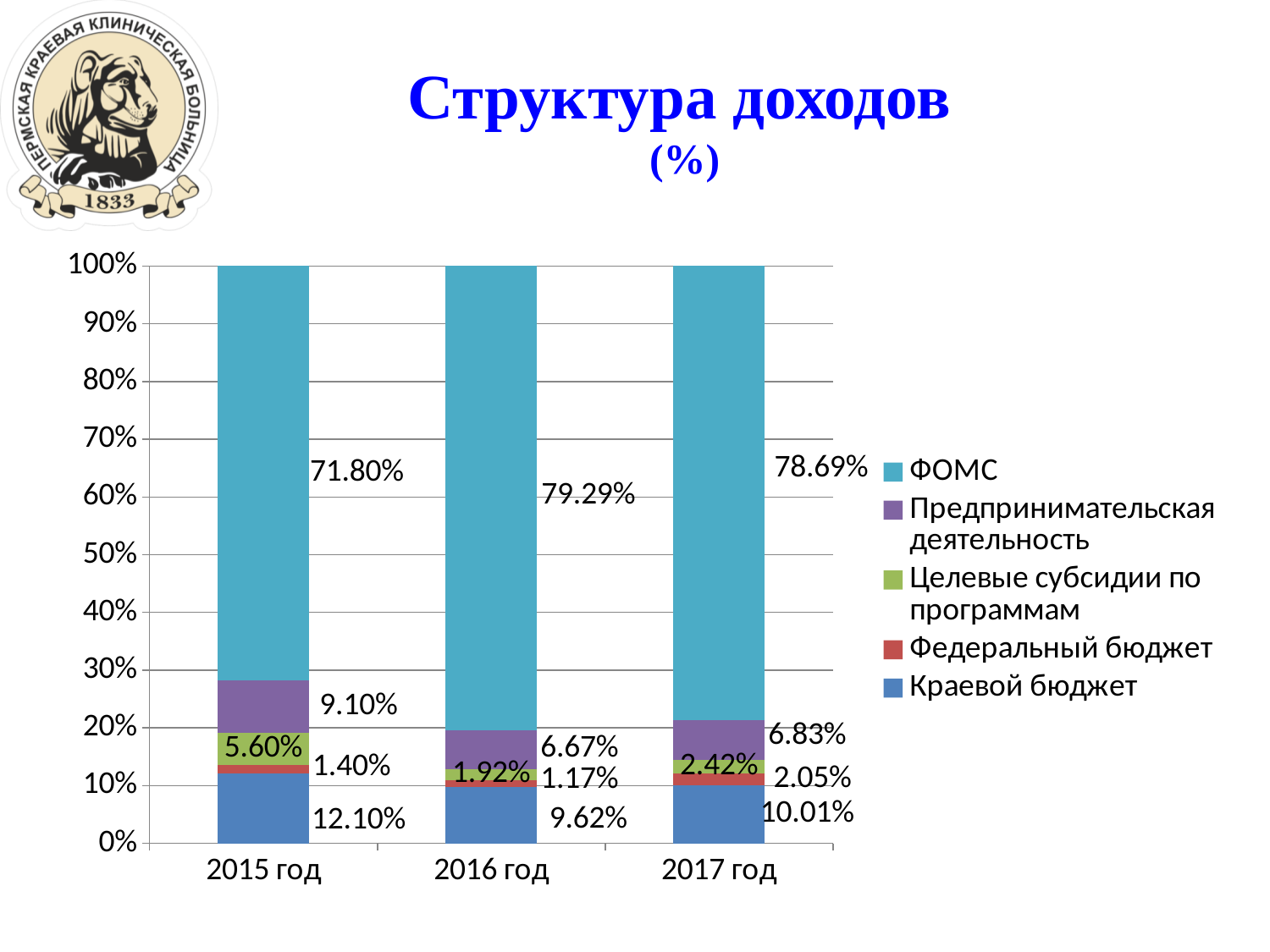
How many years are shown on the x axis? 3 What kind of chart is shown on the slide? Stacked bar chart What is the value for Целевые субсидии по программам in 2017 год? 2.42% What is the value for ФОМС in 2015 год? 71.80% What is the difference between the ФОМС share in 2016 год and in 2015 год? 7.49% What is the value for Краевой бюджет in 2016 год? 9.62% In which year is the Краевой бюджет share the lowest? 2016 год How many series does the legend list? 5 In which year is the ФОМС share the highest? 2016 год Which is larger: Предпринимательская деятельность in 2015 год or in 2016 год? 2015 год What is the value for Федеральный бюджет in 2015 год? 1.40% What is the value for Предпринимательская деятельность in 2017 год? 6.83%